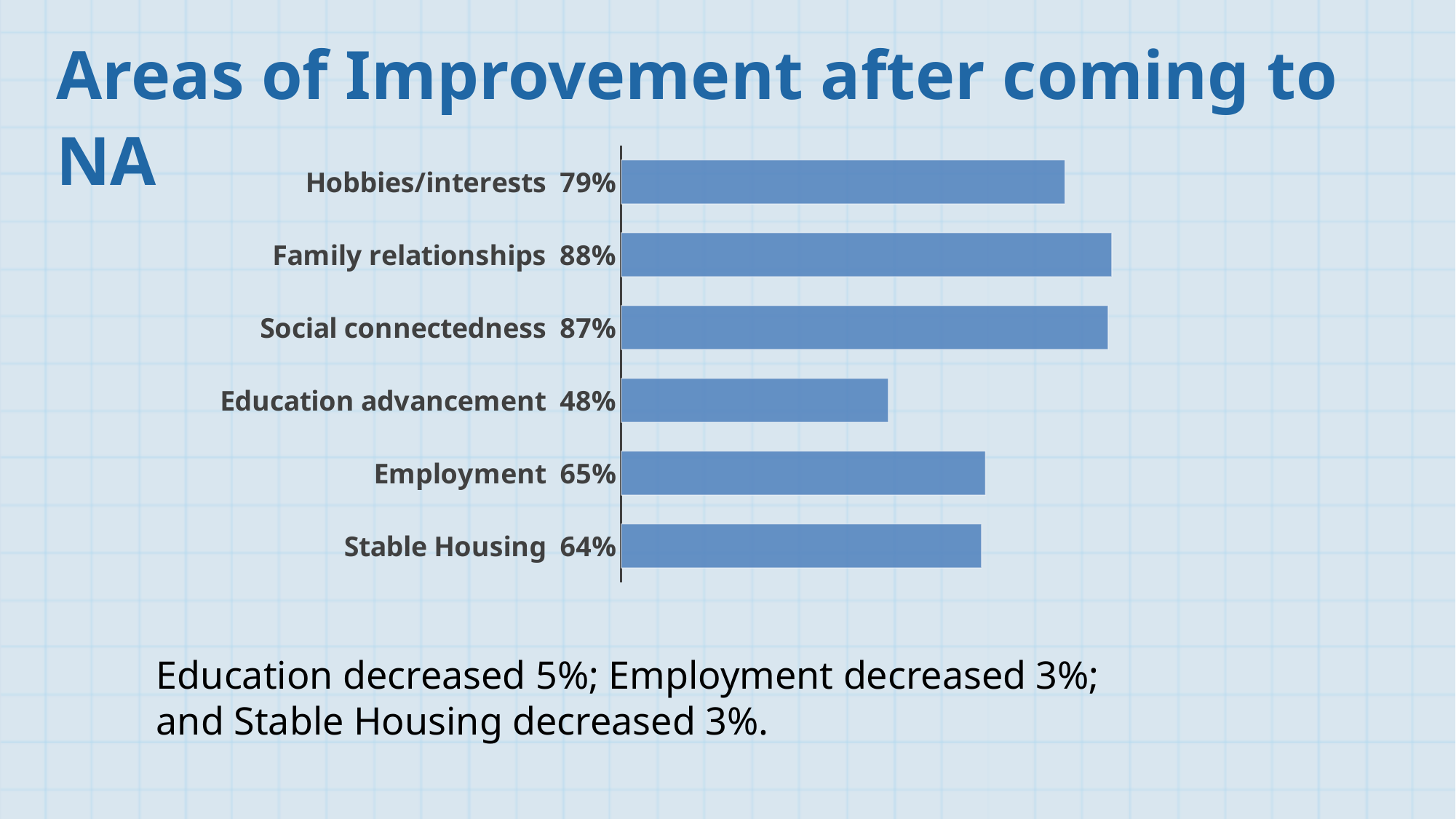
What is the title of the slide containing the chart? Areas of Improvement after coming to NA How many categories are shown in the chart? 6 What is the value for Hobbies/interests? 79% What is the value for Education advancement? 48% Which category has the lowest value? Education advancement Which category has the highest value? Family relationships What is the difference between the values for Social connectedness and Education advancement? 39% What is the value for Stable Housing? 64% What is the difference between the values for Hobbies/interests and Employment? 14% What kind of chart is shown on the slide? Bar chart What is the value for Family relationships? 88% Which is larger, the value for Hobbies/interests or the value for Social connectedness? Social connectedness